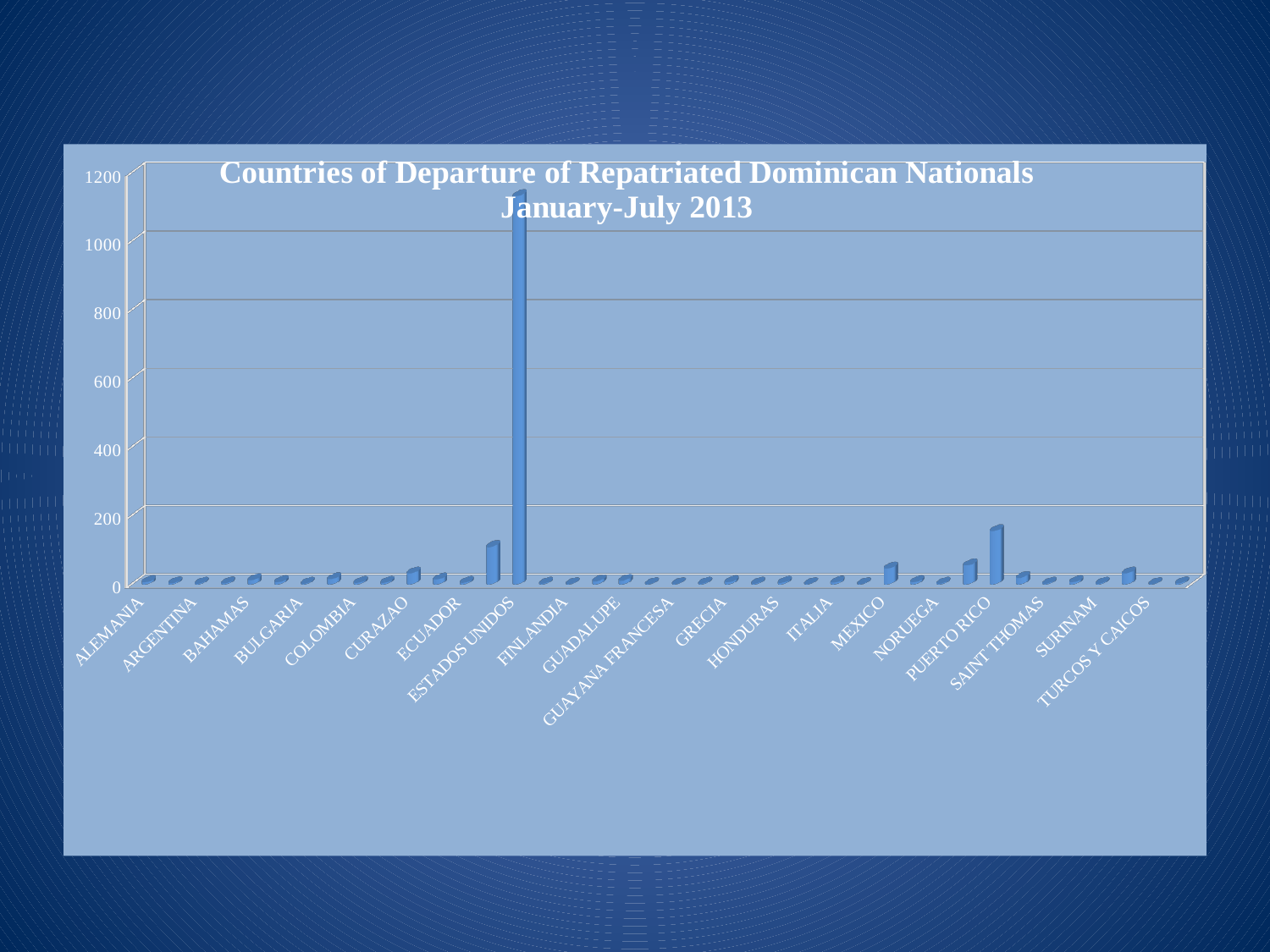
Which is larger, the value for ESTADOS UNIDOS or the value for PUERTO RICO? ESTADOS UNIDOS Which country has the highest bar in the chart? ESTADOS UNIDOS What kind of chart is shown on the slide? Bar chart Is the value for PUERTO RICO greater or less than 200? less Is the value for ALEMANIA greater or less than 200? less What is the highest value shown on the vertical axis? 1200 Which is larger, the value for PUERTO RICO or the value for ALEMANIA? PUERTO RICO What is the title of the chart? Countries of Departure of Repatriated Dominican Nationals January-July 2013 Is the value for PUERTO RICO greater or less than 400? less